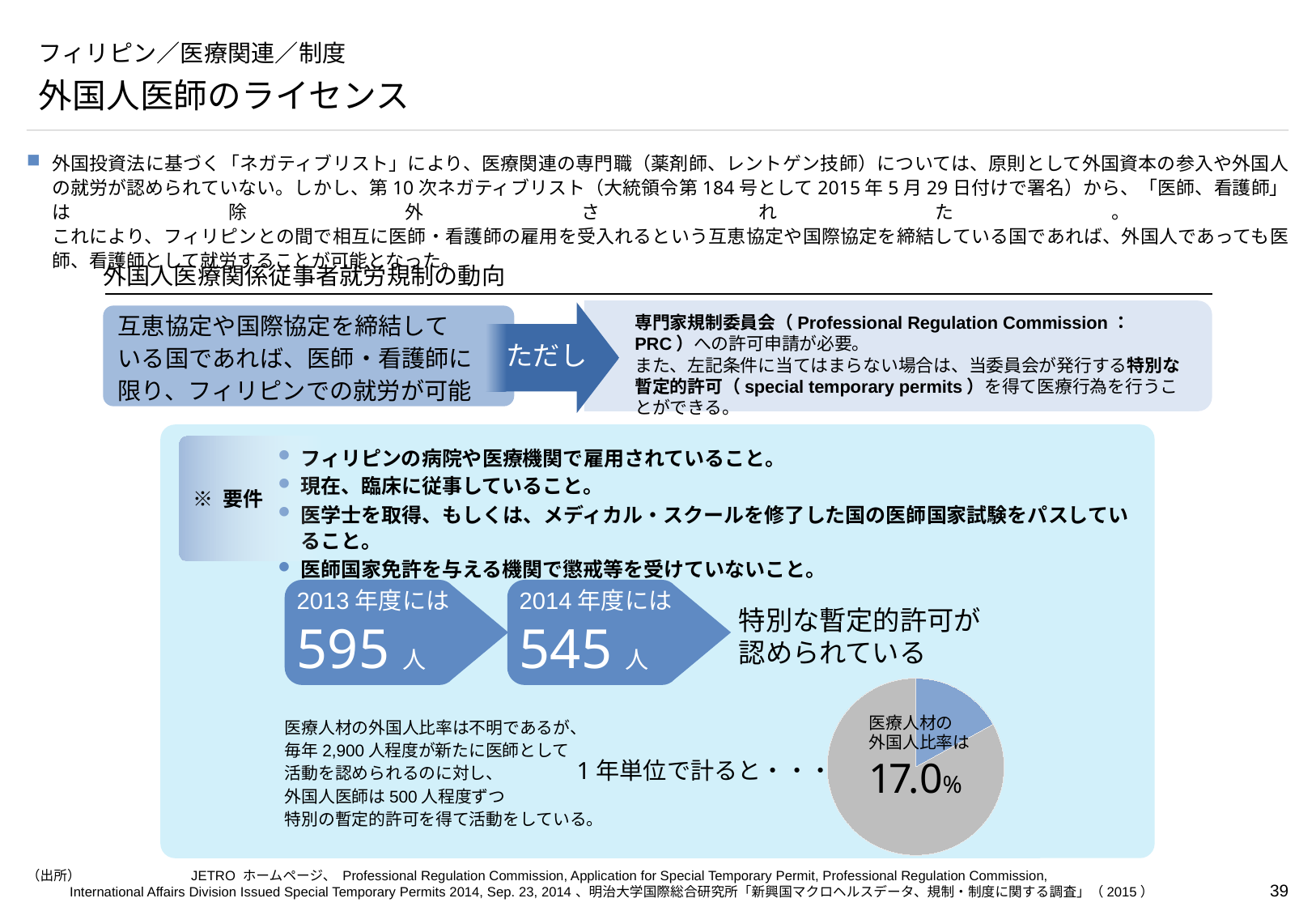
What label is written on the pie chart above the 17.0% value? 医療人材の外国人比率は What colour is the slice representing 17.0% in the pie chart? blue What kind of chart is shown at the bottom right of the slide? pie chart What percentage is printed on the pie chart for 医療人材の外国人比率? 17.0% In the pie chart, which slice is larger, the blue slice or the gray slice? the gray slice How many slices does the pie chart have? 2 What share of the pie chart does the blue slice represent? 17.0%